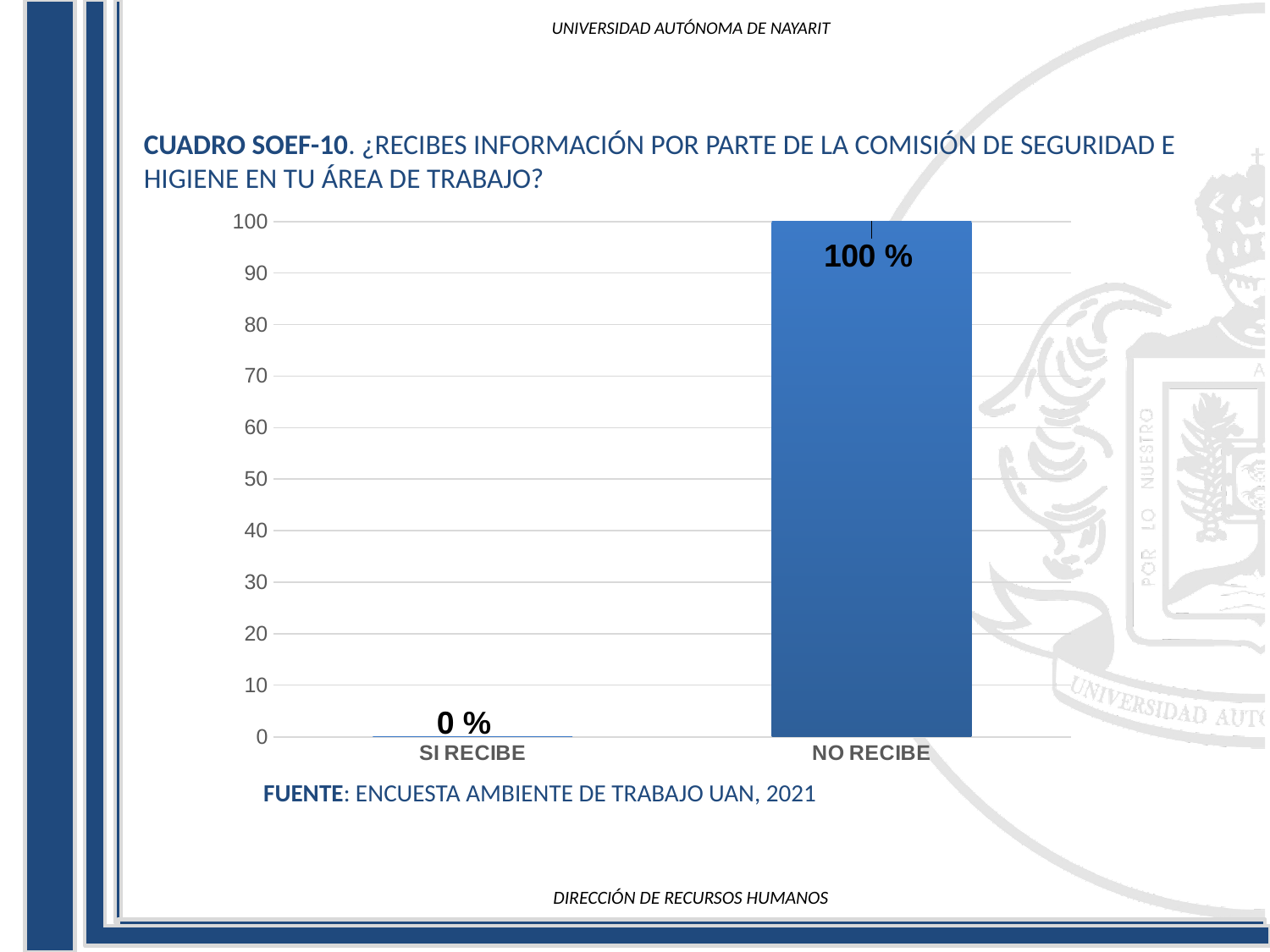
What is the value for SI RECIBE? 0 % Which category has the lowest value? SI RECIBE Which category has the highest value? NO RECIBE Which is larger, the value for SI RECIBE or the value for NO RECIBE? NO RECIBE Is the value for NO RECIBE greater or less than 50? greater What is the value for NO RECIBE? 100 % What is the highest value shown on the vertical axis? 100 What is the difference between the values for NO RECIBE and SI RECIBE? 100 % What kind of chart is shown on the slide? bar chart What source is cited below the chart? ENCUESTA AMBIENTE DE TRABAJO UAN, 2021 How many categories are shown on the x axis? 2